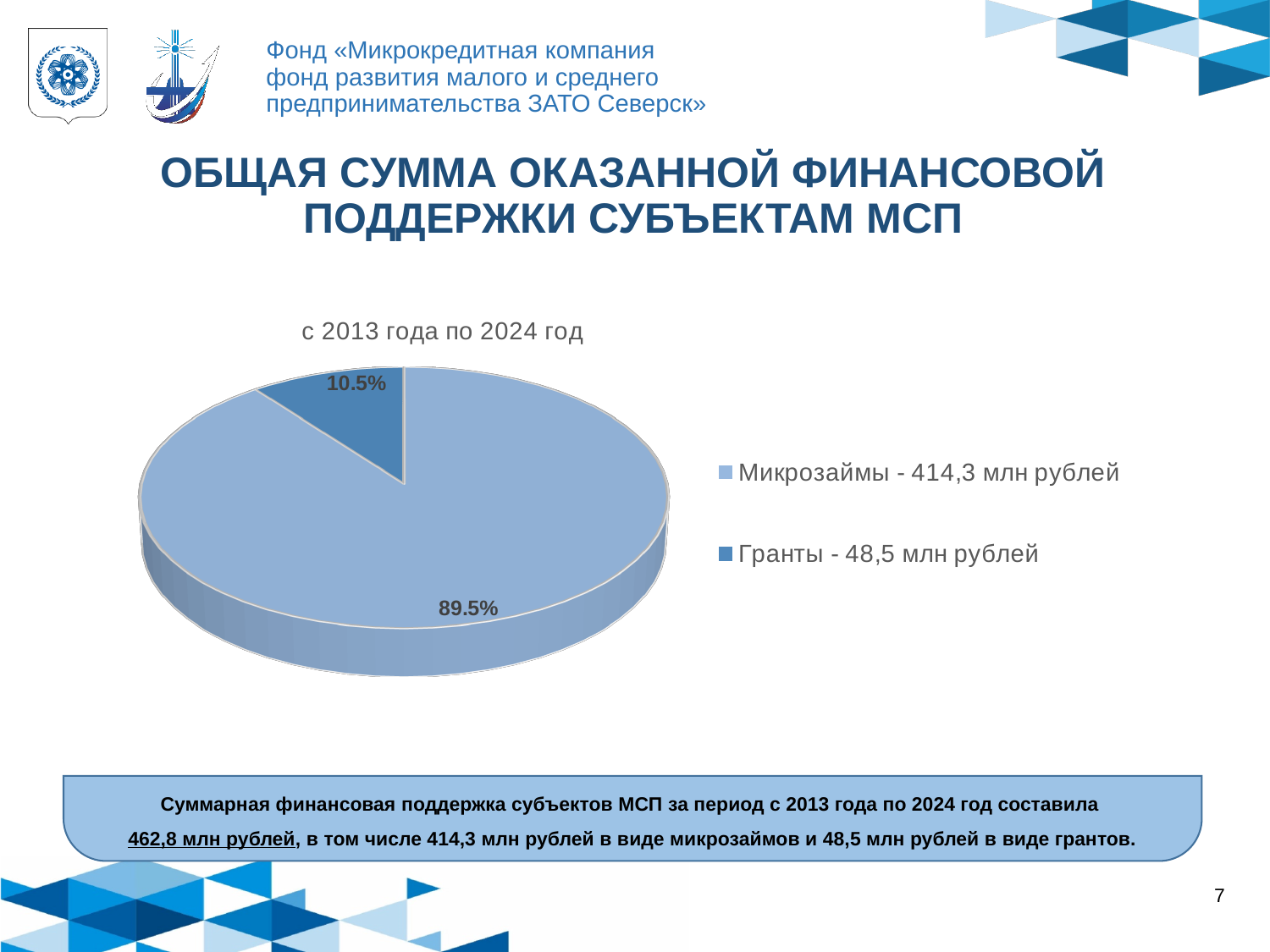
What share of the pie does the Гранты slice represent? 10.5% Which slice of the pie chart is the smallest? Гранты How many slices does the pie chart have? 2 According to the legend, what amount in млн рублей corresponds to Микрозаймы? 414,3 млн рублей Which is larger in the pie chart, Микрозаймы or Гранты? Микрозаймы What is the title shown above the pie chart? с 2013 года по 2024 год Which slice of the pie chart is the largest? Микрозаймы What share of the pie does the Микрозаймы slice represent? 89.5% What kind of chart is shown on the slide? pie chart What is the difference in percentage points between the Микрозаймы and Гранты slices? 79 percentage points According to the legend, what amount in млн рублей corresponds to Гранты? 48,5 млн рублей How many entries does the legend of the pie chart list? 2